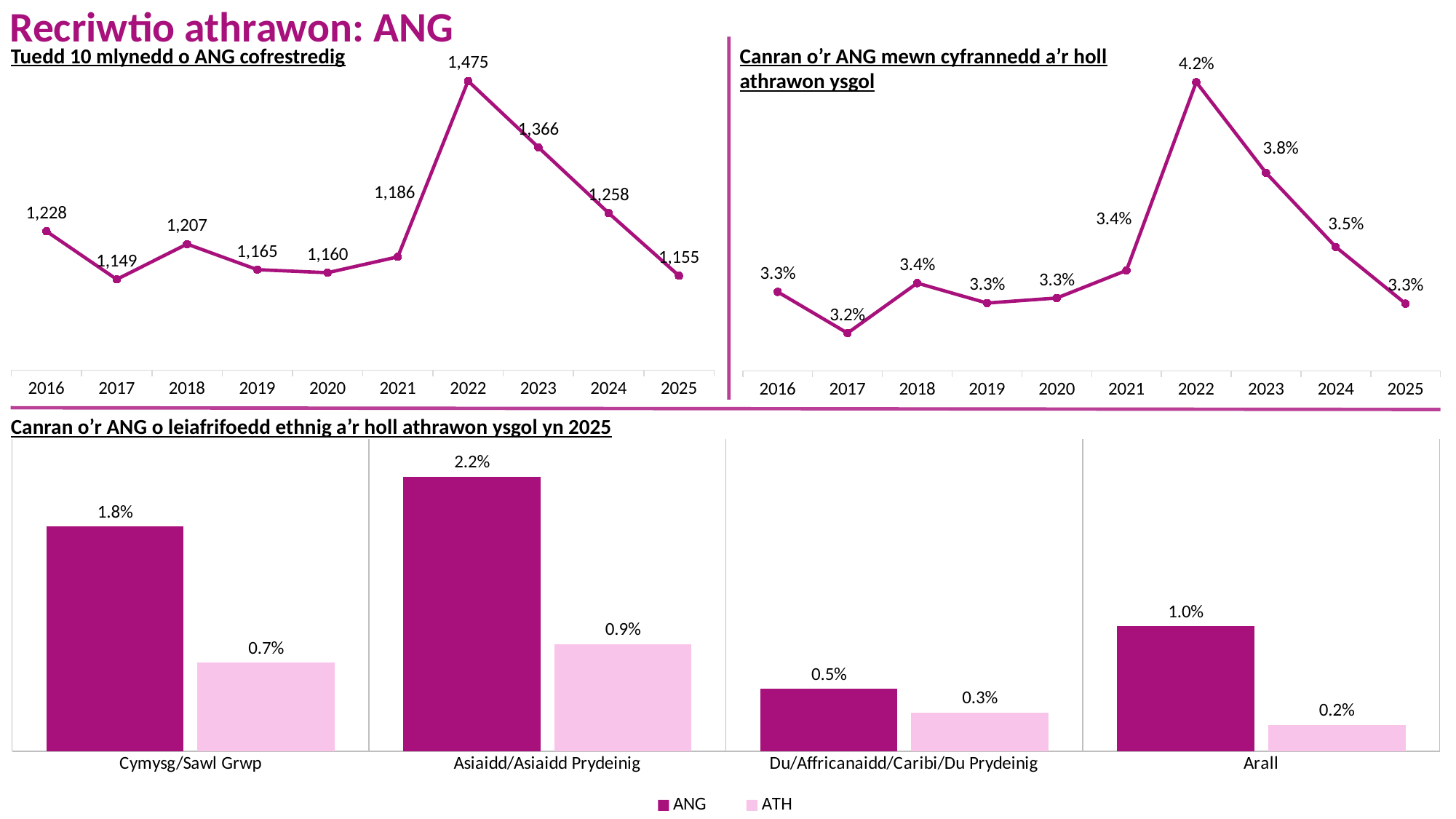
In the top-left chart 'Tuedd 10 mlynedd o ANG cofrestredig', how many years are plotted? 10 In the bottom chart 'Canran o'r ANG o leiafrifoedd ethnig a'r holl athrawon ysgol yn 2025', what is the ANG value for Asiaidd/Asiaidd Prydeinig? 2.2% How many series does the legend of the bottom chart 'Canran o'r ANG o leiafrifoedd ethnig a'r holl athrawon ysgol yn 2025' list? 2 In the top-left chart 'Tuedd 10 mlynedd o ANG cofrestredig', what is the difference between the 2022 and 2023 values? 109 In the bottom chart 'Canran o'r ANG o leiafrifoedd ethnig a'r holl athrawon ysgol yn 2025', which category has the highest ANG value? Asiaidd/Asiaidd Prydeinig In the top-right chart 'Canran o'r ANG mewn cyfrannedd a'r holl athrawon ysgol', which year has the lowest value? 2017 In the top-left chart 'Tuedd 10 mlynedd o ANG cofrestredig', what is the value for 2022? 1,475 In the top-left chart 'Tuedd 10 mlynedd o ANG cofrestredig', which year has the lowest value? 2017 In the bottom chart 'Canran o'r ANG o leiafrifoedd ethnig a'r holl athrawon ysgol yn 2025', what is the ATH value for Arall? 0.2% What kind of chart is the bottom chart 'Canran o'r ANG o leiafrifoedd ethnig a'r holl athrawon ysgol yn 2025'? bar chart In the top-right chart 'Canran o'r ANG mewn cyfrannedd a'r holl athrawon ysgol', what is the value for 2022? 4.2% In the top-right chart 'Canran o'r ANG mewn cyfrannedd a'r holl athrawon ysgol', do the values rise or fall from 2022 to 2025? fall